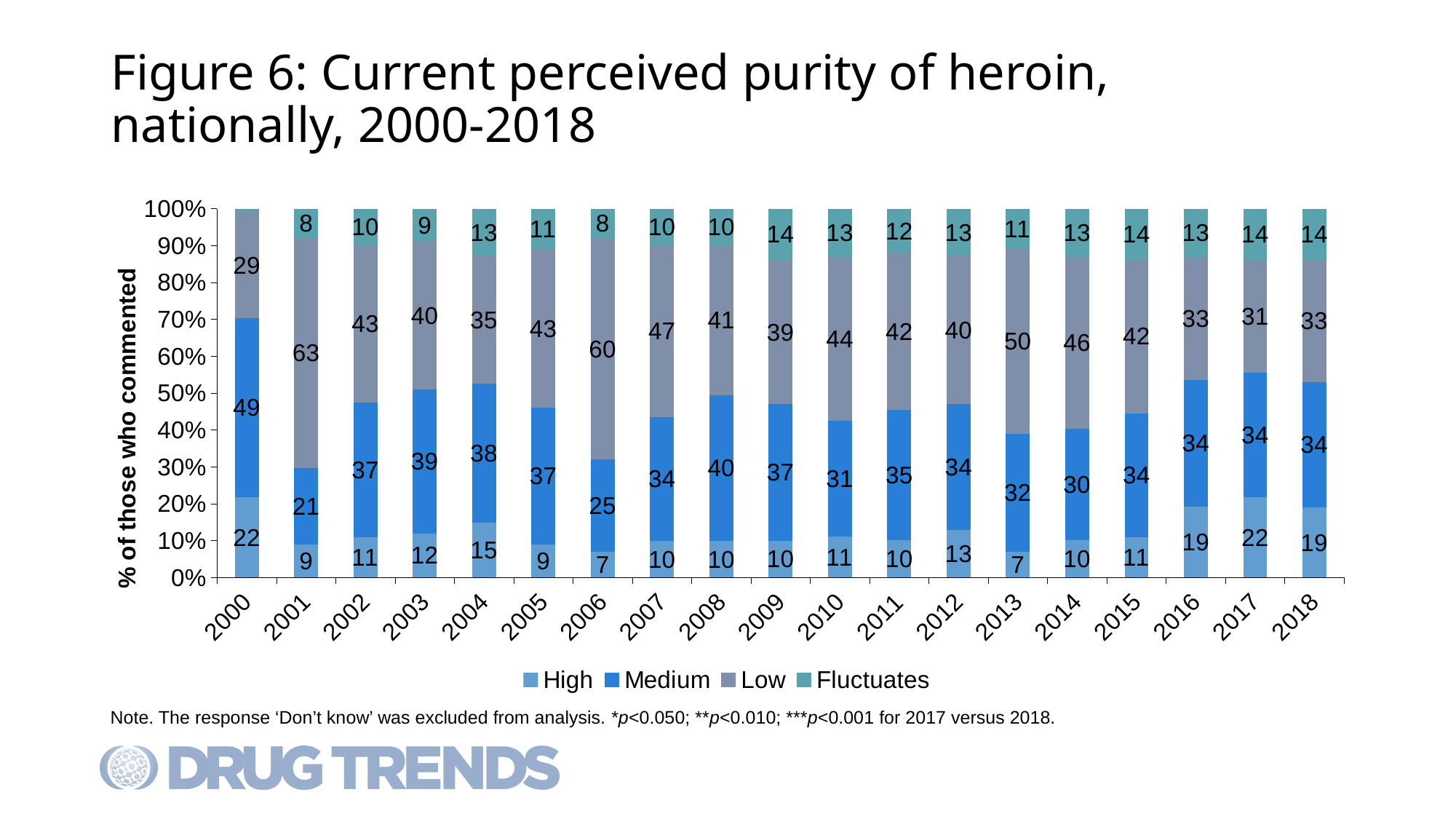
Which is larger: the 'High' value in 2017 or the 'High' value in 2013? 2017 What is the label of the y axis? % of those who commented What is the 'Medium' value for 2018? 34 What is the difference between the 'Low' value in 2006 and the 'Low' value in 2018? 27 What is the 'Fluctuates' value for 2009? 14 What kind of chart is shown on the slide? Stacked bar chart In which year is the 'Medium' segment the largest? 2000 In which year is the 'Medium' segment the smallest? 2001 In which year is the 'Low' segment the largest? 2001 How many series does the legend list? 4 What percentage of those who commented rated heroin purity as 'Low' in 2001? 63 How many years are shown on the x axis? 19